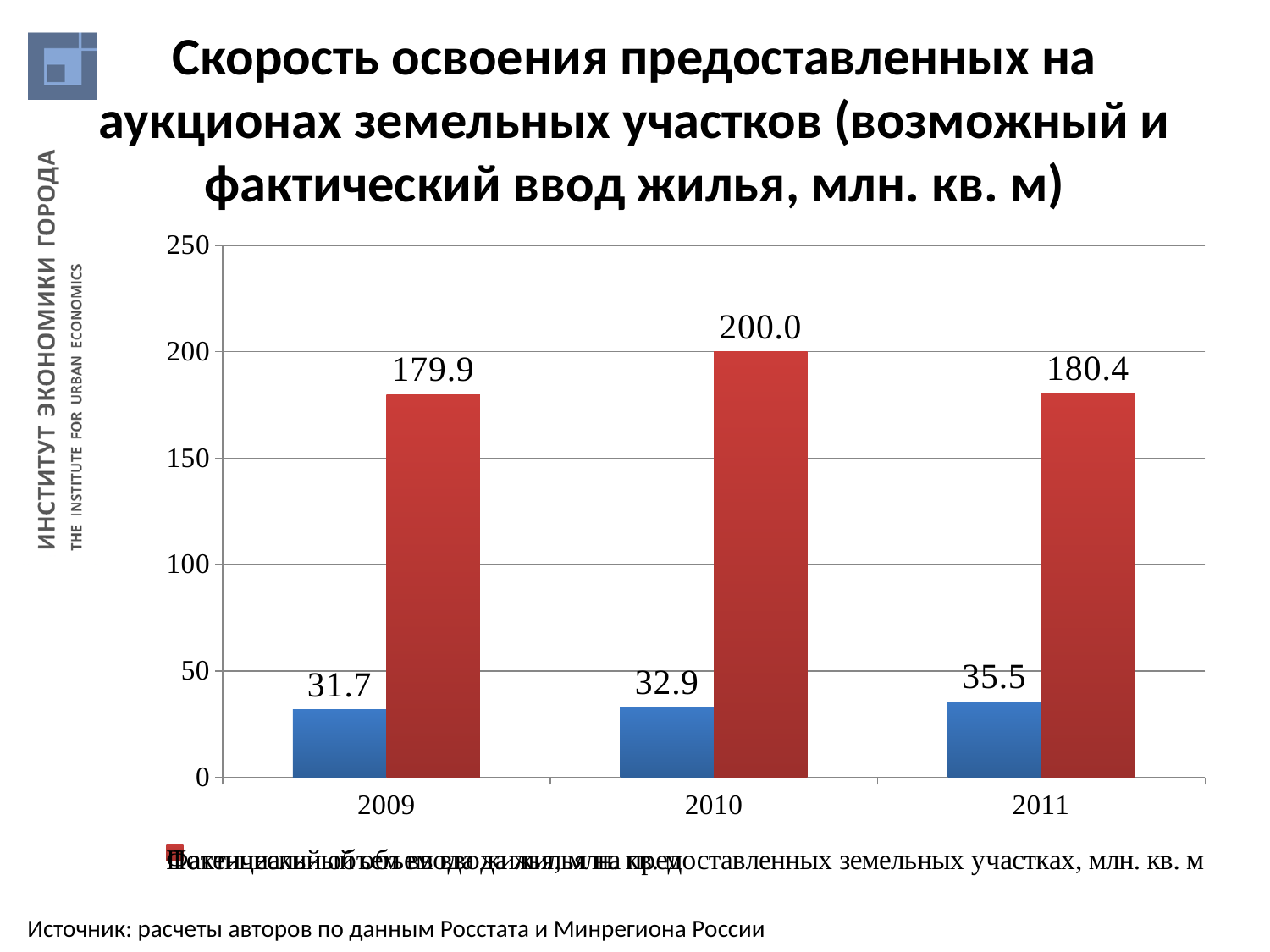
Which is larger: the red bar for 2011 or the red bar for 2009? 2011 What is the difference between the red bar and the blue bar in 2011? 144.9 How many data series are plotted in the chart? 2 In which year is the red bar highest? 2010 How many years are shown on the x axis? 3 What is the difference between the blue bar values for 2011 and 2009? 3.8 What is the value of the red bar for 2010? 200.0 What is the value of the red bar for 2009? 179.9 What is the value of the blue bar for 2011? 35.5 What is the value of the blue bar for 2009? 31.7 What kind of chart is shown on the slide? bar chart In which year is the blue bar lowest? 2009